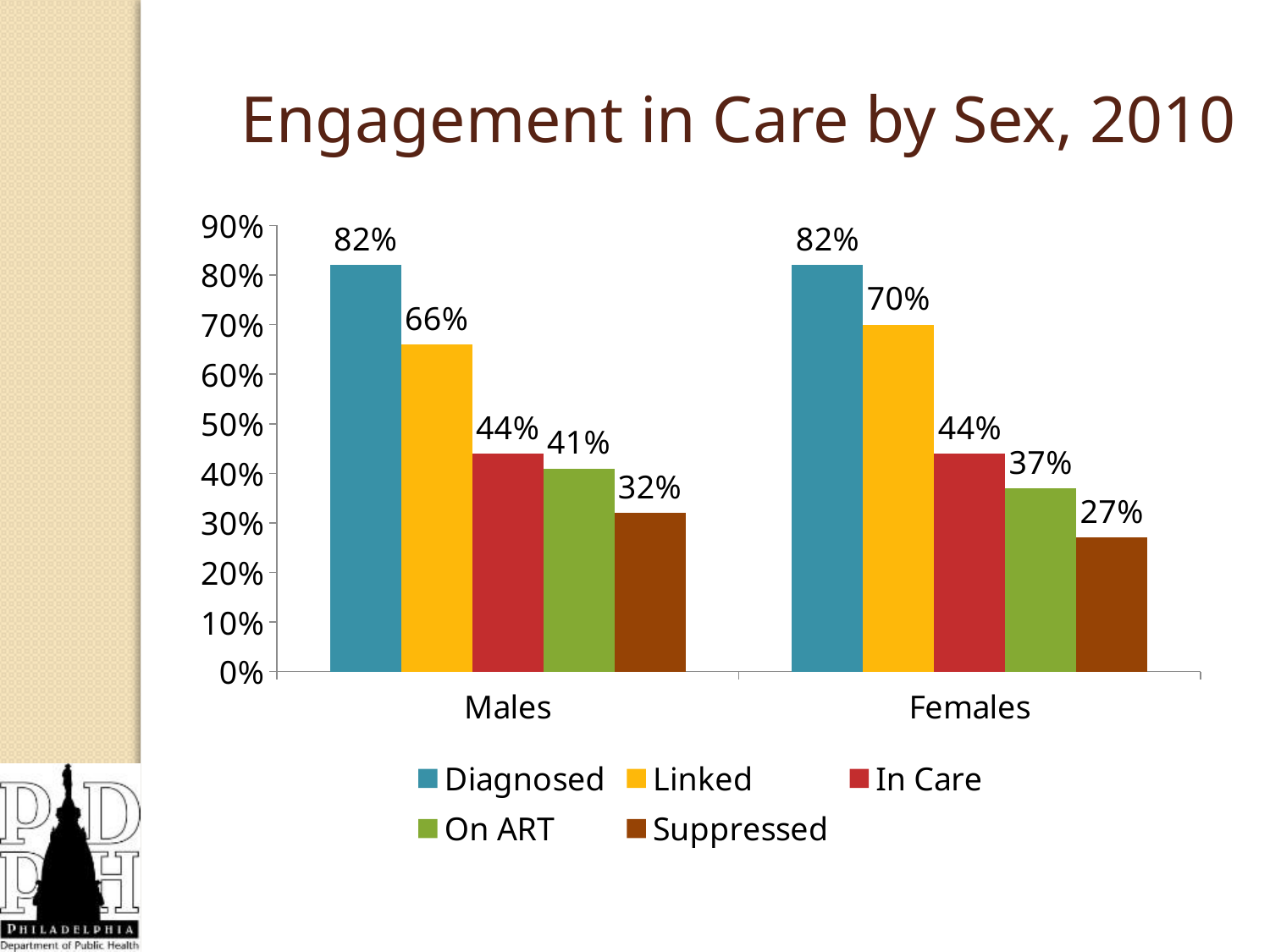
Which is larger, the On ART value for Males or for Females? Males How many series does the legend list? 5 How many categories are shown on the x axis? 2 What is the Linked value for Males? 66% What is the Suppressed value for Females? 27% Which series has the highest value for Females? Diagnosed What is the On ART value for Females? 37% What is the difference between the Diagnosed and Suppressed values for Males? 50% What is the difference between the Linked values for Females and Males? 4% Which series has the lowest value for Males? Suppressed What is the title of the chart? Engagement in Care by Sex, 2010 What kind of chart is shown on the slide? Bar chart